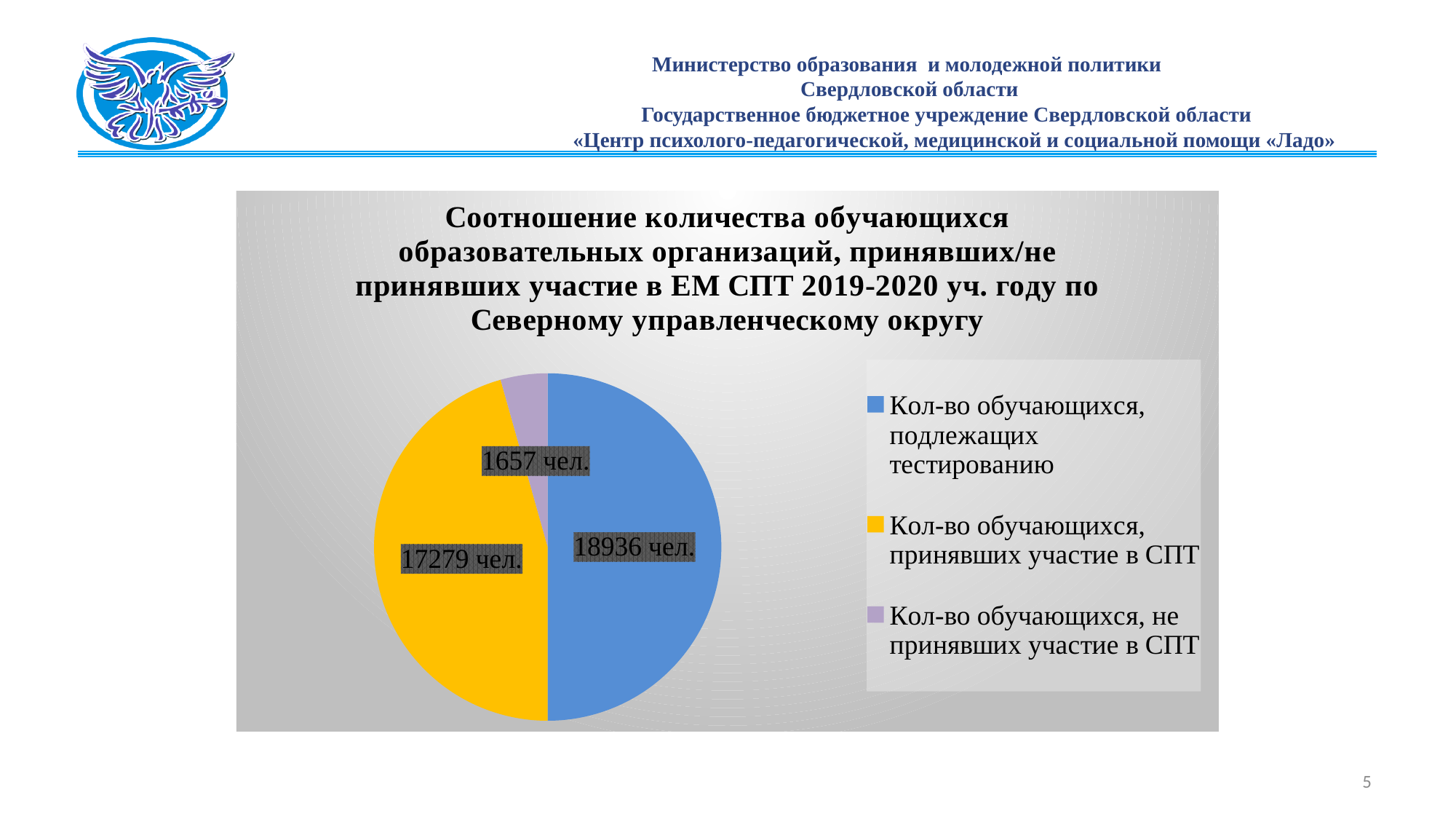
Which category has the largest slice of the pie? Кол-во обучающихся, подлежащих тестированию What share of the pie does the slice "Кол-во обучающихся, подлежащих тестированию" represent? 50% What is the value for "Кол-во обучающихся, не принявших участие в СПТ"? 1657 чел. What is the value for "Кол-во обучающихся, подлежащих тестированию"? 18936 чел. What is the value for "Кол-во обучающихся, принявших участие в СПТ"? 17279 чел. What type of chart is shown on the slide? Pie chart How many slices does the pie chart have? 3 Which category has the smallest slice of the pie? Кол-во обучающихся, не принявших участие в СПТ What colour is the slice for "Кол-во обучающихся, принявших участие в СПТ"? Yellow Which is larger: the number of students who took part in СПТ or the number who did not take part? Кол-во обучающихся, принявших участие в СПТ What is the difference between the number of students subject to testing and the number who took part in СПТ? 1657 How many entries does the legend of the pie chart list? 3